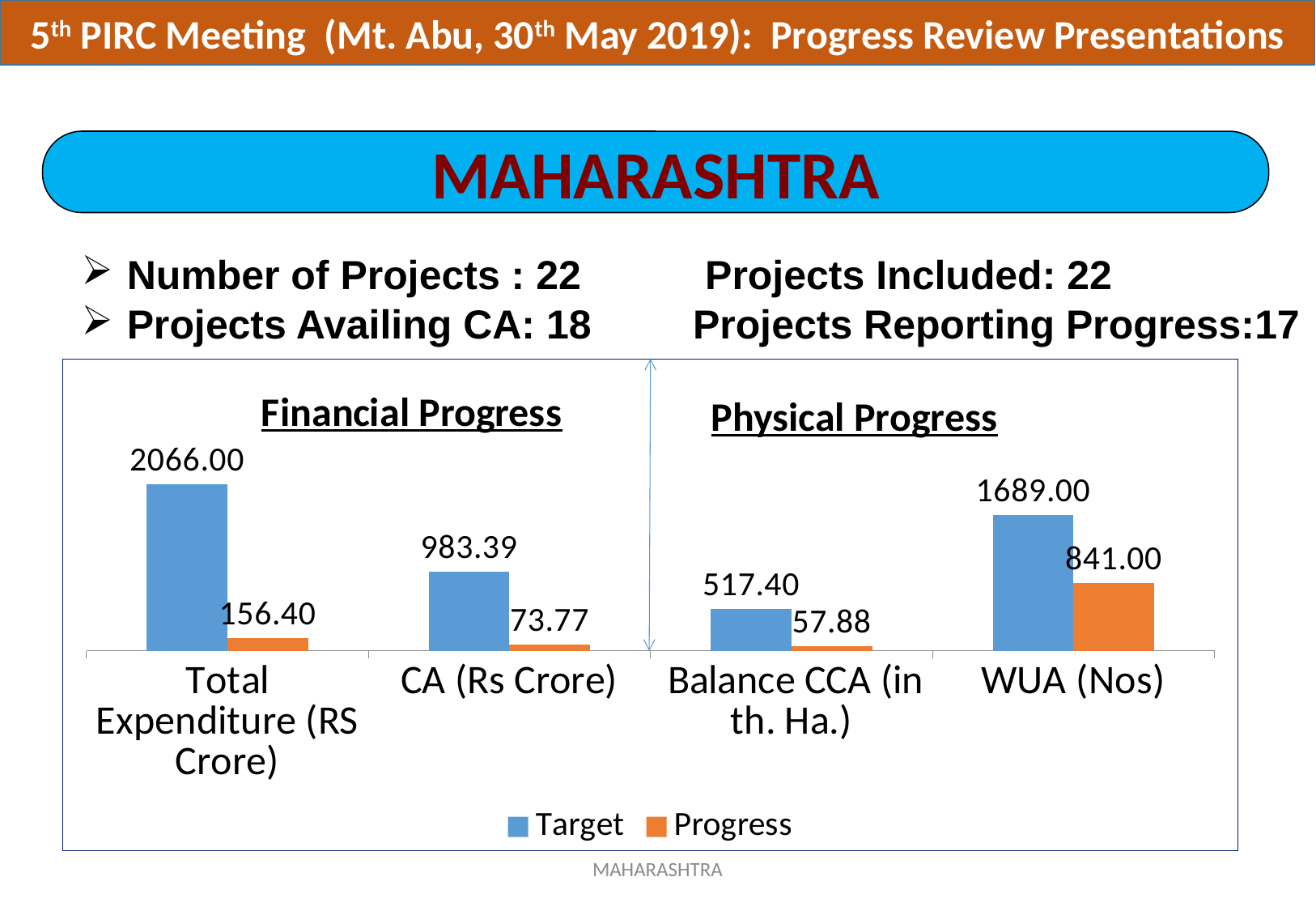
What is the Progress value for CA (Rs Crore)? 73.77 What is the Target value for Balance CCA (in th. Ha.)? 517.40 Which category has the lowest Progress value? Balance CCA (in th. Ha.) What is the Progress value for WUA (Nos)? 841.00 Which category has the highest Target value? Total Expenditure (RS Crore) Which series is shown in orange in the chart? Progress Which is larger: the Progress value for Total Expenditure (RS Crore) or the Progress value for WUA (Nos)? WUA (Nos) How many series does the chart legend list? 2 What is the Target value for Total Expenditure (RS Crore)? 2066.00 What kind of chart is shown on the slide? Bar chart How many categories are shown on the x axis of the chart? 4 What is the difference between the Target and Progress values for WUA (Nos)? 848.00